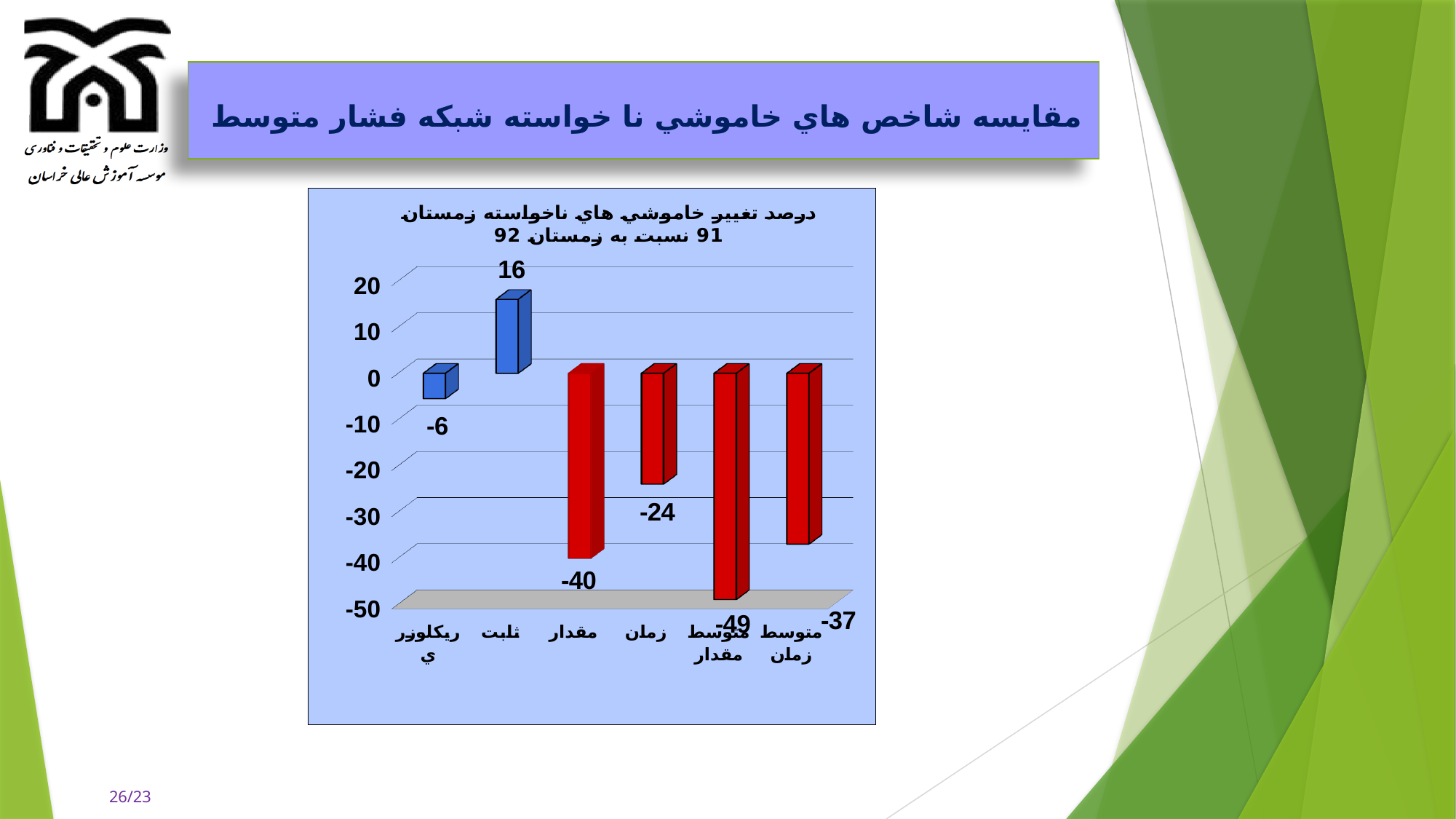
How many categories are shown on the x axis? 6 What is the value for زمان? -24 What is the value for مقدار? -40 What is the value for متوسط مقدار? -49 What kind of chart is shown on the slide? bar chart What is the value for ثابت? 16 What is the value for ریکلوزری? -6 What is the difference between the values for ثابت and مقدار? 56 Which category has the lowest value? متوسط مقدار Which is larger, the value for زمان or the value for متوسط زمان? زمان Which category has the highest value? ثابت What is the value for متوسط زمان? -37